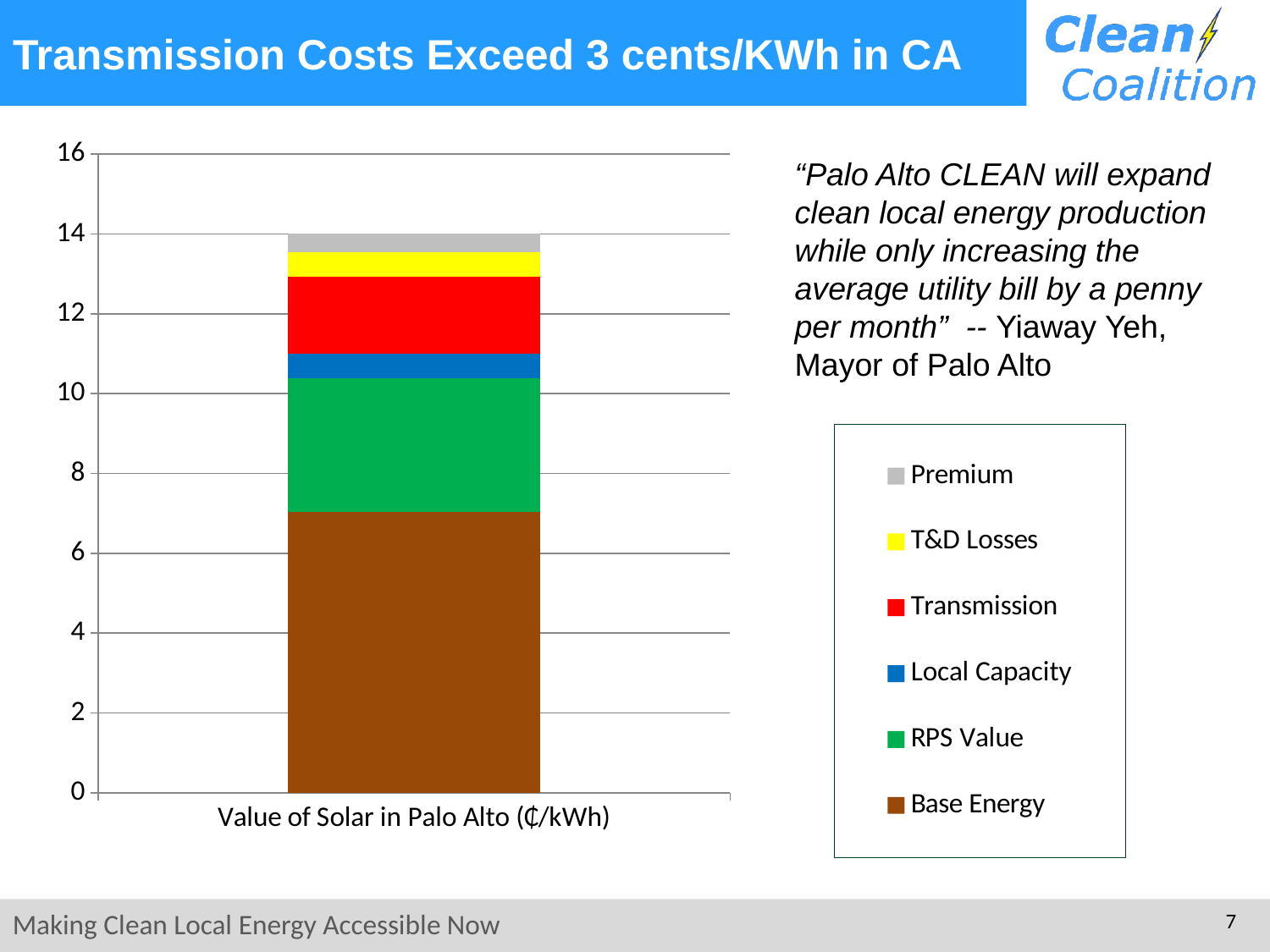
Which segment is larger, RPS Value or Transmission? RPS Value Which segment is larger, Base Energy or RPS Value? Base Energy Which series makes up the largest segment of the stacked bar? Base Energy What colour represents Transmission in the legend? red How many bars (categories) are plotted on the chart? 1 What is the total height of the stacked bar for Value of Solar in Palo Alto (¢/kWh)? 14 Is the RPS Value segment greater or less than 2? greater How many series does the legend list? 6 Is the Base Energy segment greater or less than 6? greater Is the Base Energy segment greater or less than 8? less What kind of chart is shown on the slide? stacked bar chart What is the label shown under the bar on the x axis? Value of Solar in Palo Alto (₵/kWh)